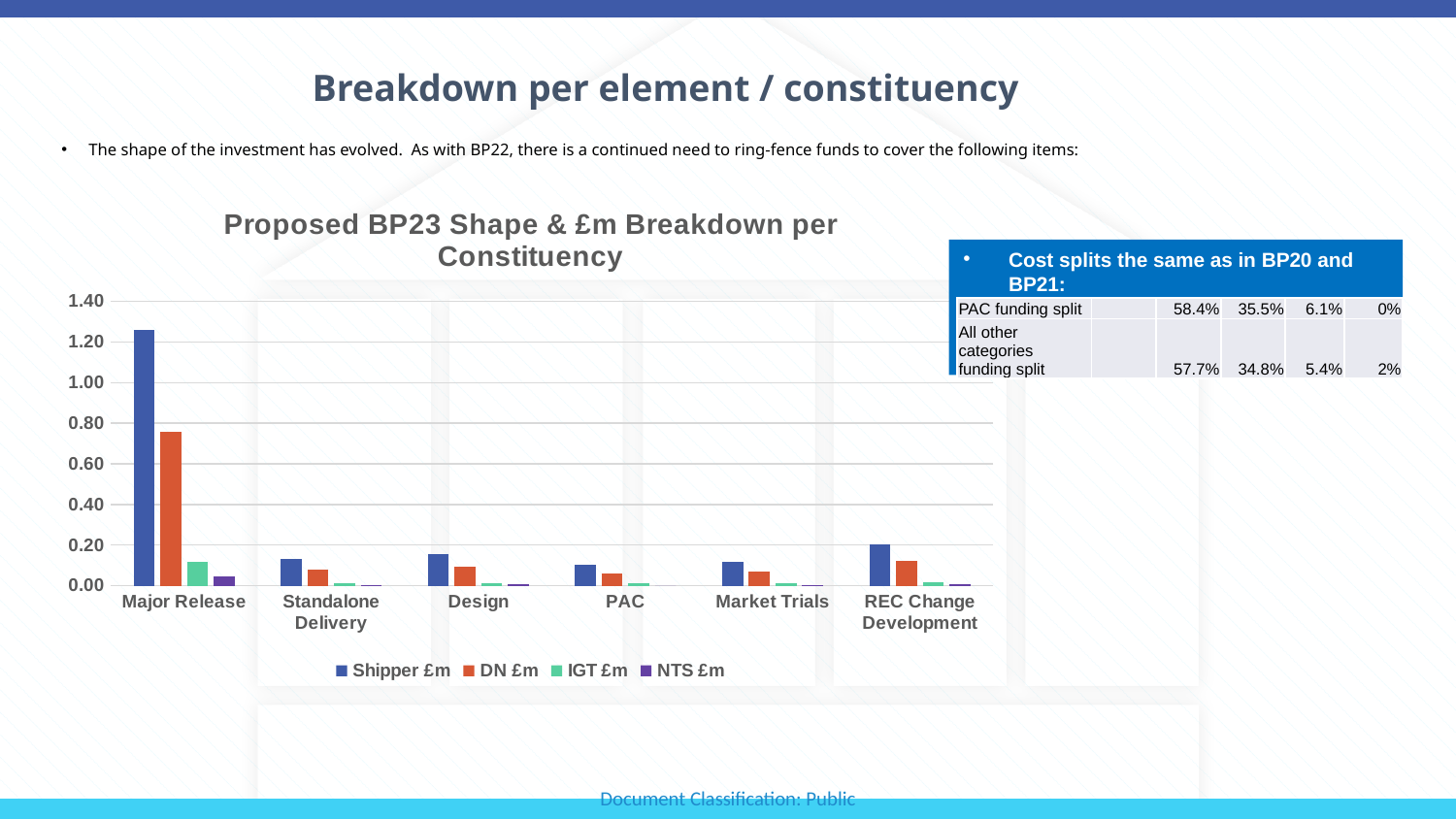
Which series is shown in orange in the chart? DN £m What kind of chart is shown on the slide? bar chart Which category has the highest Shipper £m value? Major Release What is the title of the chart? Proposed BP23 Shape & £m Breakdown per Constituency Which category has the larger Shipper £m value, Design or REC Change Development? REC Change Development Which is larger for Major Release, the Shipper £m value or the DN £m value? Shipper £m Is the Shipper £m value for REC Change Development greater or less than 0.40? less How many series does the chart legend list? 4 Is the Shipper £m value for Major Release greater or less than 1.00? greater How many categories are shown on the x axis of the chart? 6 Which category has the highest DN £m value? Major Release Is the DN £m value for Major Release greater or less than 0.60? greater